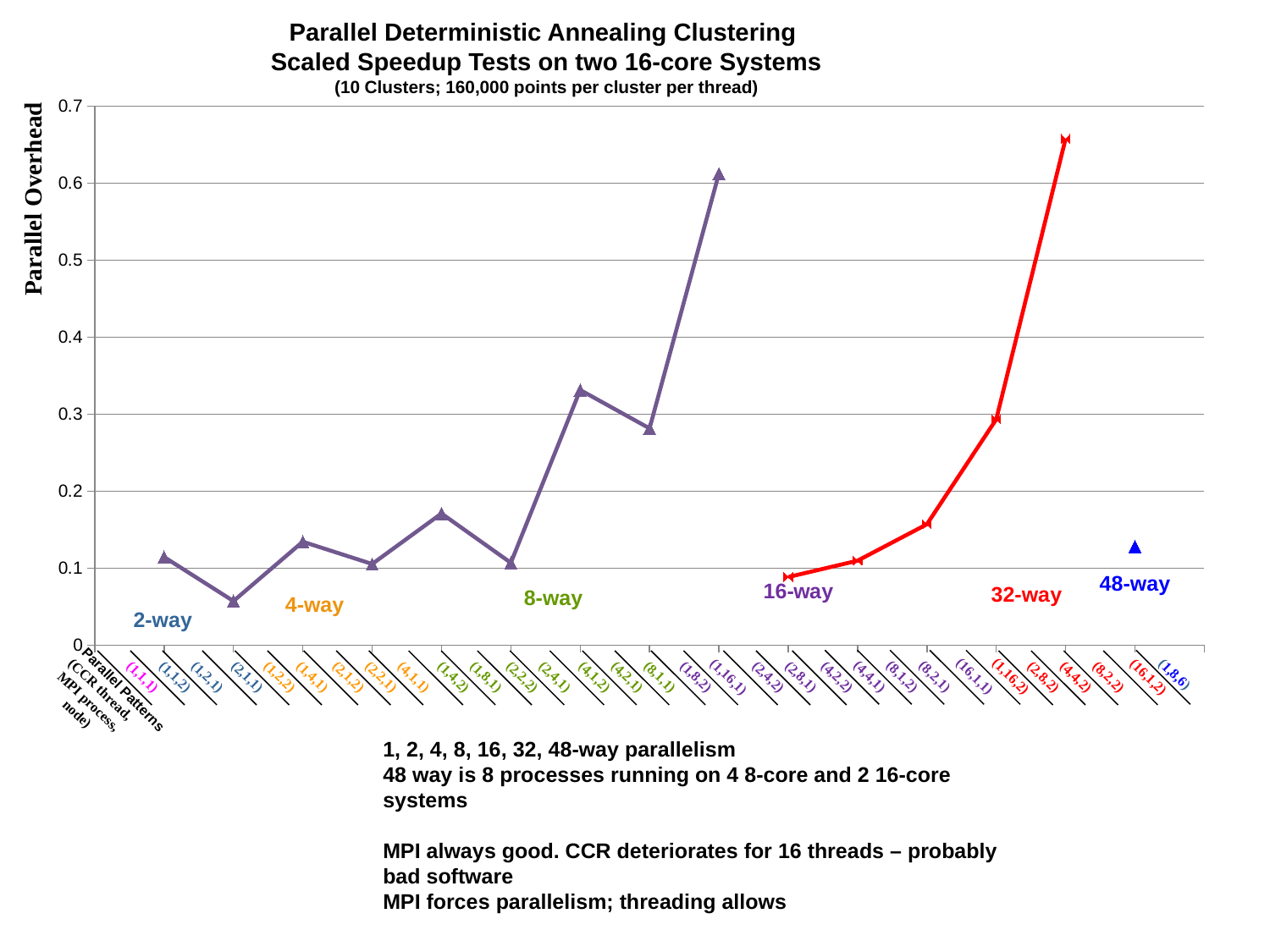
Which is larger: the highest point of the 8-way line or the 48-way point? the highest point of the 8-way line Is the first point of the 16-way line greater or less than 0.2? less What is the title of the chart? Parallel Deterministic Annealing Clustering Scaled Speedup Tests on two 16-core Systems Which is larger: the highest point of the 32-way line or the highest point of the 8-way line? the highest point of the 32-way line What kind of chart is shown on the slide? line chart Is the lowest point of the 2-way group greater or less than 0.1? less Which parallelism group reaches the highest parallel overhead on the chart? 32-way Does the red 32-way line rise or fall as it moves from left to right along the x axis? rises Is the value of the single 48-way point greater or less than 0.2? less What is the label on the vertical axis of the chart? Parallel Overhead